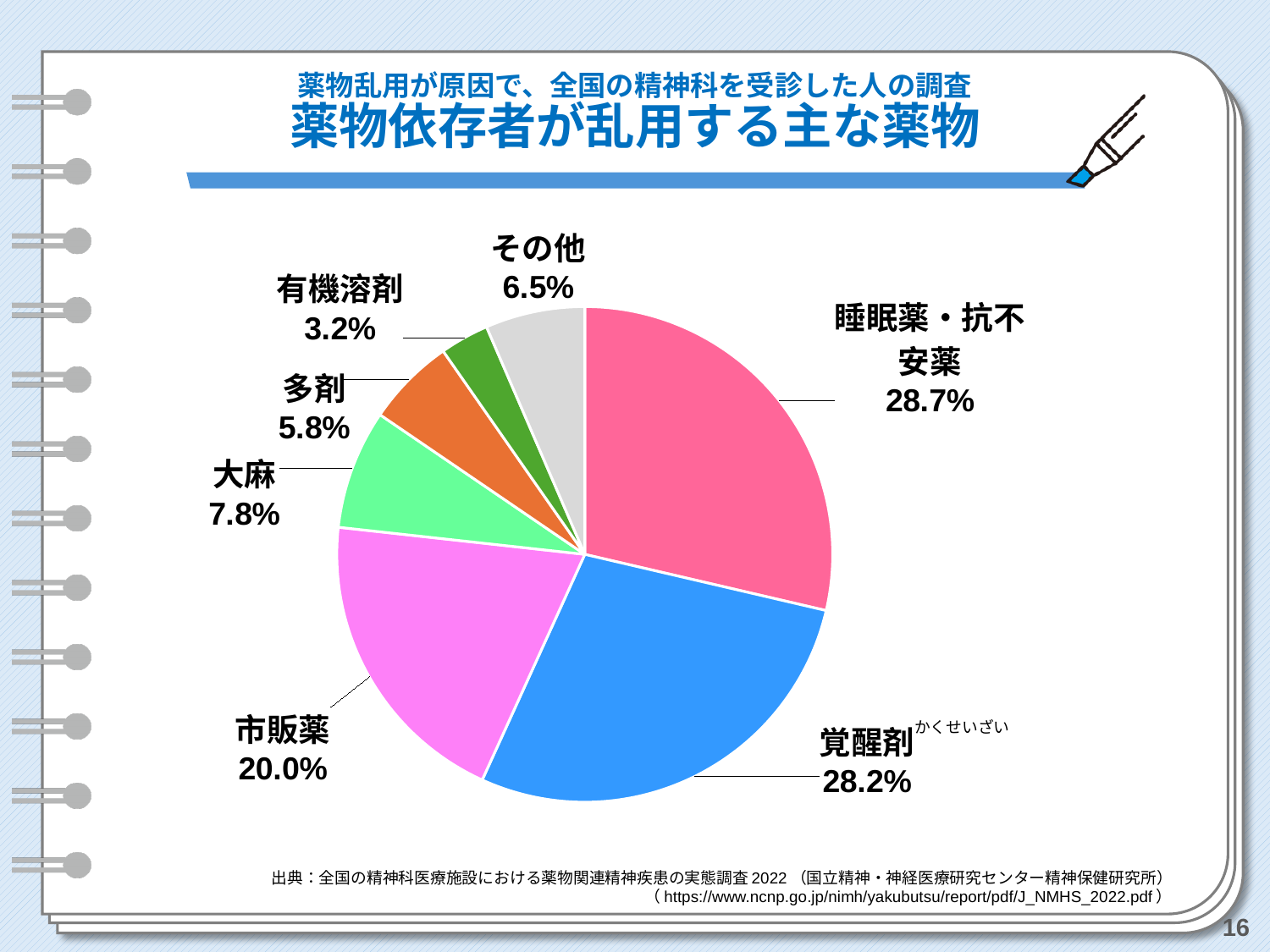
What is the share for 市販薬? 20.0% What is the share for 大麻? 7.8% What type of chart is shown on the slide? pie chart Which category has the smallest share of the pie? 有機溶剤 How many categories are shown in the pie chart? 7 What is the share for 有機溶剤? 3.2% Which category has the largest share of the pie? 睡眠薬・抗不安薬 Which has a larger share, 多剤 or その他? その他 What is the difference between the shares of 市販薬 and 大麻? 12.2% What is the difference between the shares of 睡眠薬・抗不安薬 and 覚醒剤? 0.5% What is the share for 覚醒剤? 28.2% What is the main title of the chart on the slide? 薬物依存者が乱用する主な薬物